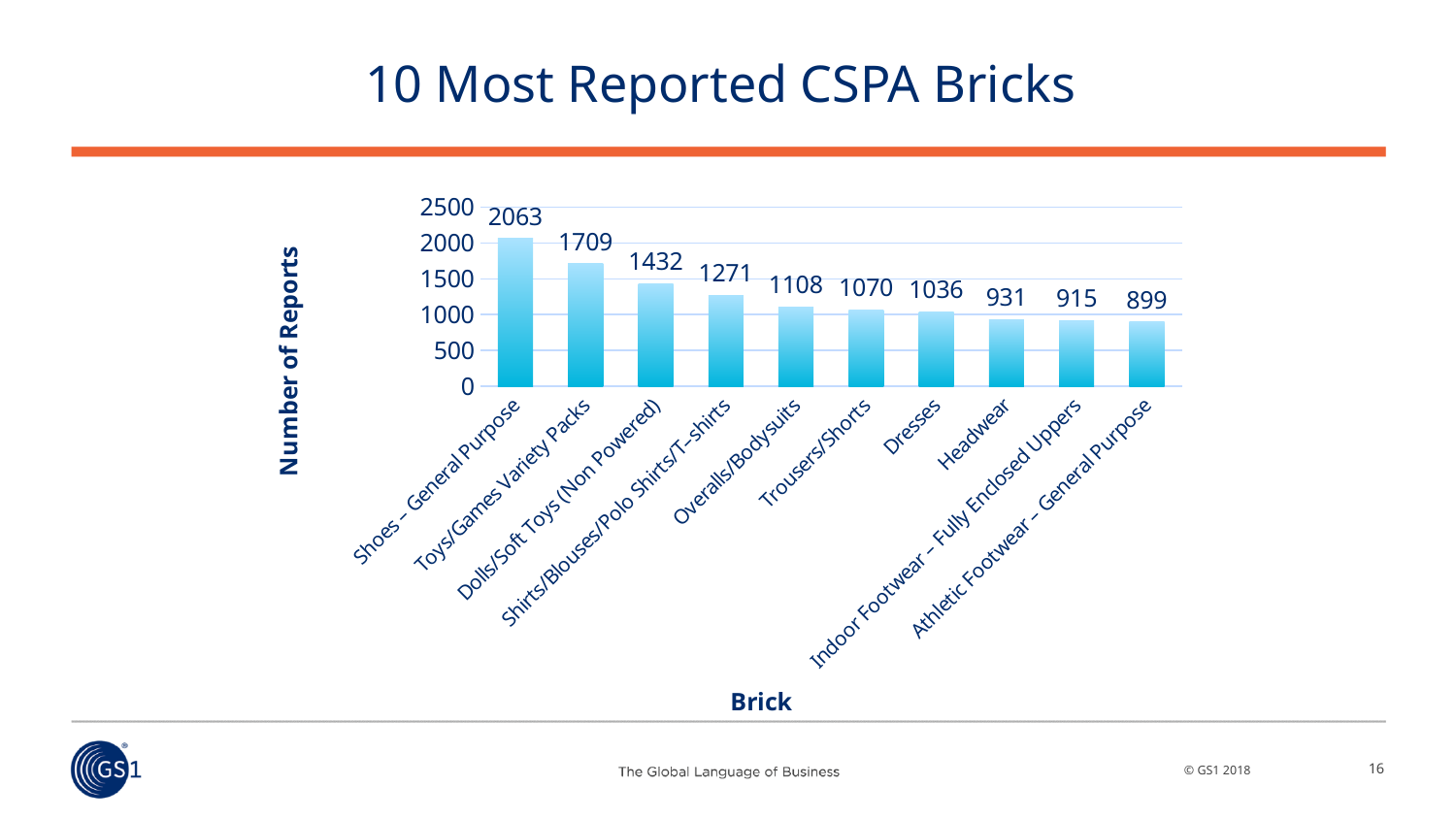
What is the number of reports for Toys/Games Variety Packs? 1709 Which brick has the highest number of reports? Shoes – General Purpose What type of chart is shown on the slide? bar chart What is the label of the vertical axis? Number of Reports Which brick has the lowest number of reports? Athletic Footwear – General Purpose What is the value for Headwear? 931 How many reports are shown for Dresses? 1036 How many bricks are shown on the chart? 10 What is the difference in reports between Shoes – General Purpose and Toys/Games Variety Packs? 354 What is the difference between the values for Dolls/Soft Toys (Non Powered) and Overalls/Bodysuits? 324 Is the value for Shirts/Blouses/Polo Shirts/T-shirts greater or less than 1500? less Which has more reports, Trousers/Shorts or Indoor Footwear – Fully Enclosed Uppers? Trousers/Shorts